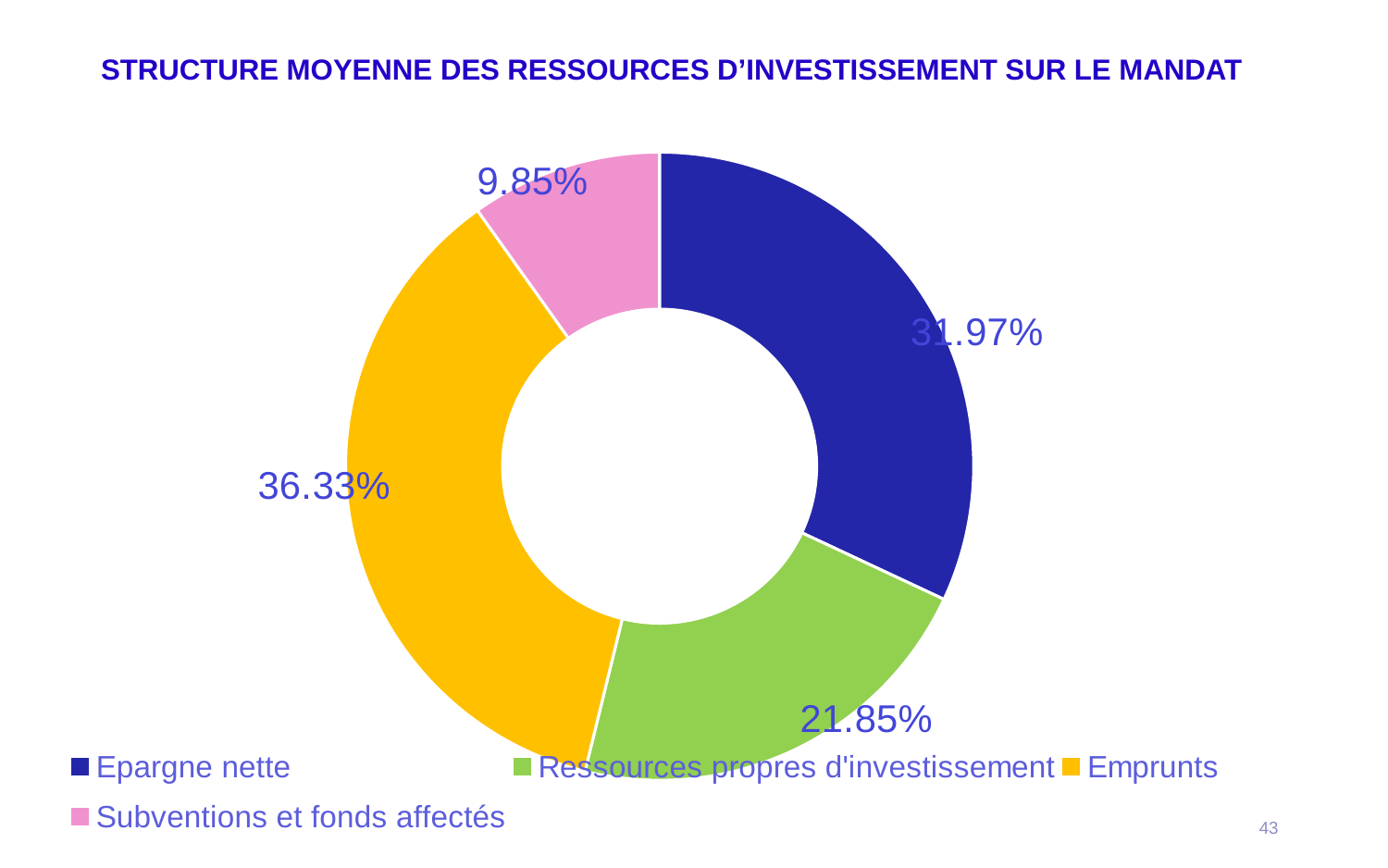
Which category has the smallest share of the chart? Subventions et fonds affectés What percentage is shown for Ressources propres d'investissement? 21.85% What colour is the Emprunts slice? Yellow What is the value shown for Epargne nette? 31.97% What is the difference in percentage points between Epargne nette and Ressources propres d'investissement? 10.12 How many categories does the chart show? 4 What is the difference in percentage points between Emprunts and Epargne nette? 4.36 What kind of chart is shown on the slide? Doughnut chart Which category has the largest share of the chart? Emprunts What is the value for Subventions et fonds affectés? 9.85% What share of the chart does Emprunts represent? 36.33% Which is larger, the share for Ressources propres d'investissement or the share for Subventions et fonds affectés? Ressources propres d'investissement